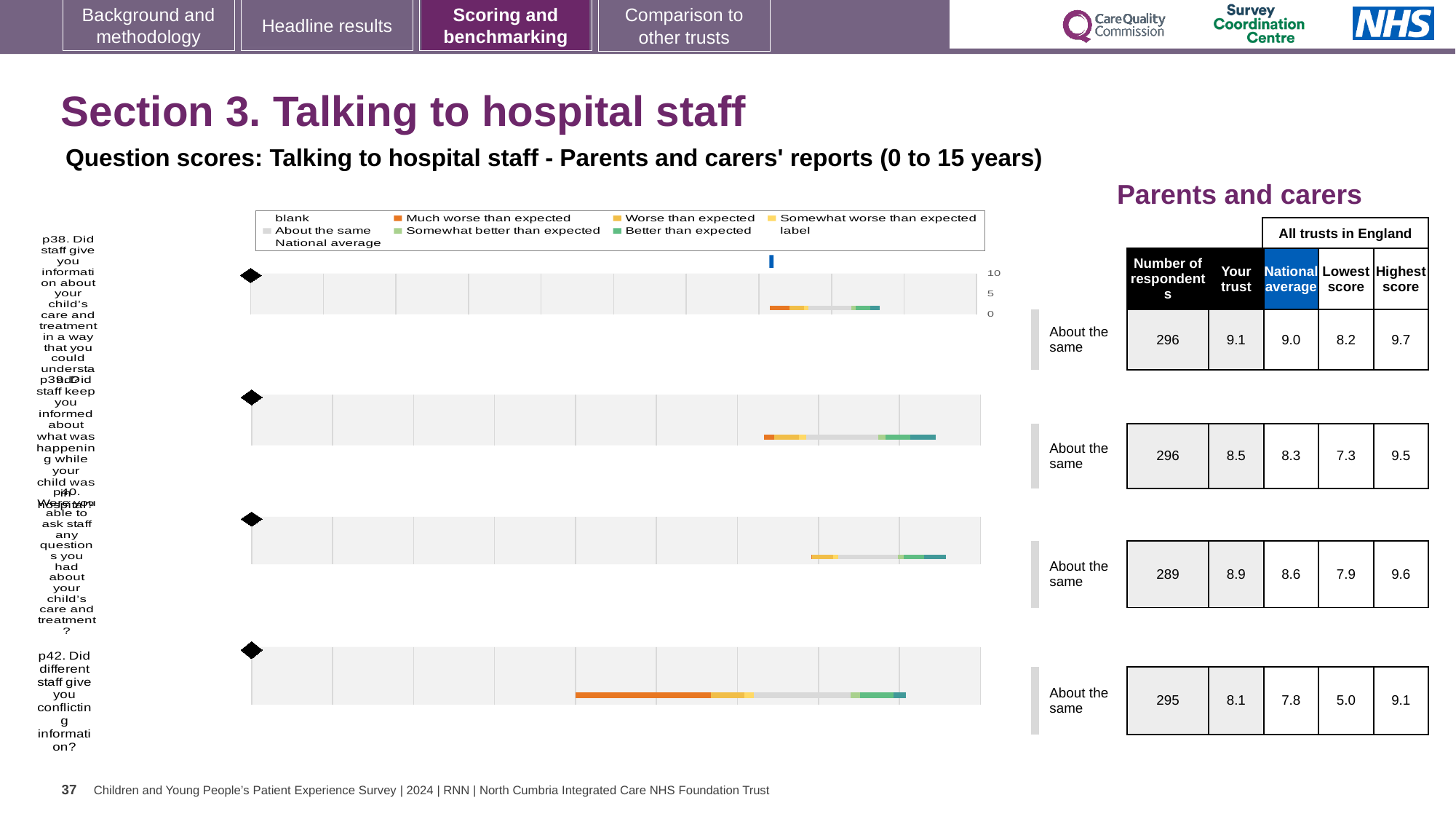
What benchmarking category label is shown beside each of the four charts on this slide? About the same Which of the four questions on the slide has the highest 'Your trust' score in the table? p38 Which of the four questions on the slide has the lowest 'Lowest score' value in the table? p42 How many survey questions (p38, p39, p40, p42) have a benchmarking bar chart on this slide? 4 In the table next to the charts, what is the 'Your trust' score for p38 (Did staff give you information about your child's care and treatment in a way that you could understand)? 9.1 In the table next to the charts, what is the Lowest score for p42 (Did different staff give you conflicting information)? 5.0 What is the title shown above the table on the right of the slide? Parents and carers What kind of chart is used to show the benchmarking results for each question on this slide? bar chart For p42, what is the difference between the Highest score and the Lowest score shown in the table? 4.1 In the table next to the charts, how many respondents are listed for p40 (Were you able to ask staff any questions you had about your child's care and treatment)? 289 In the table next to the charts, what is the National average score for p39 (Did staff keep you informed about what was happening while your child was in hospital)? 8.3 For p40, which is larger in the table: the 'Your trust' score or the National average? Your trust